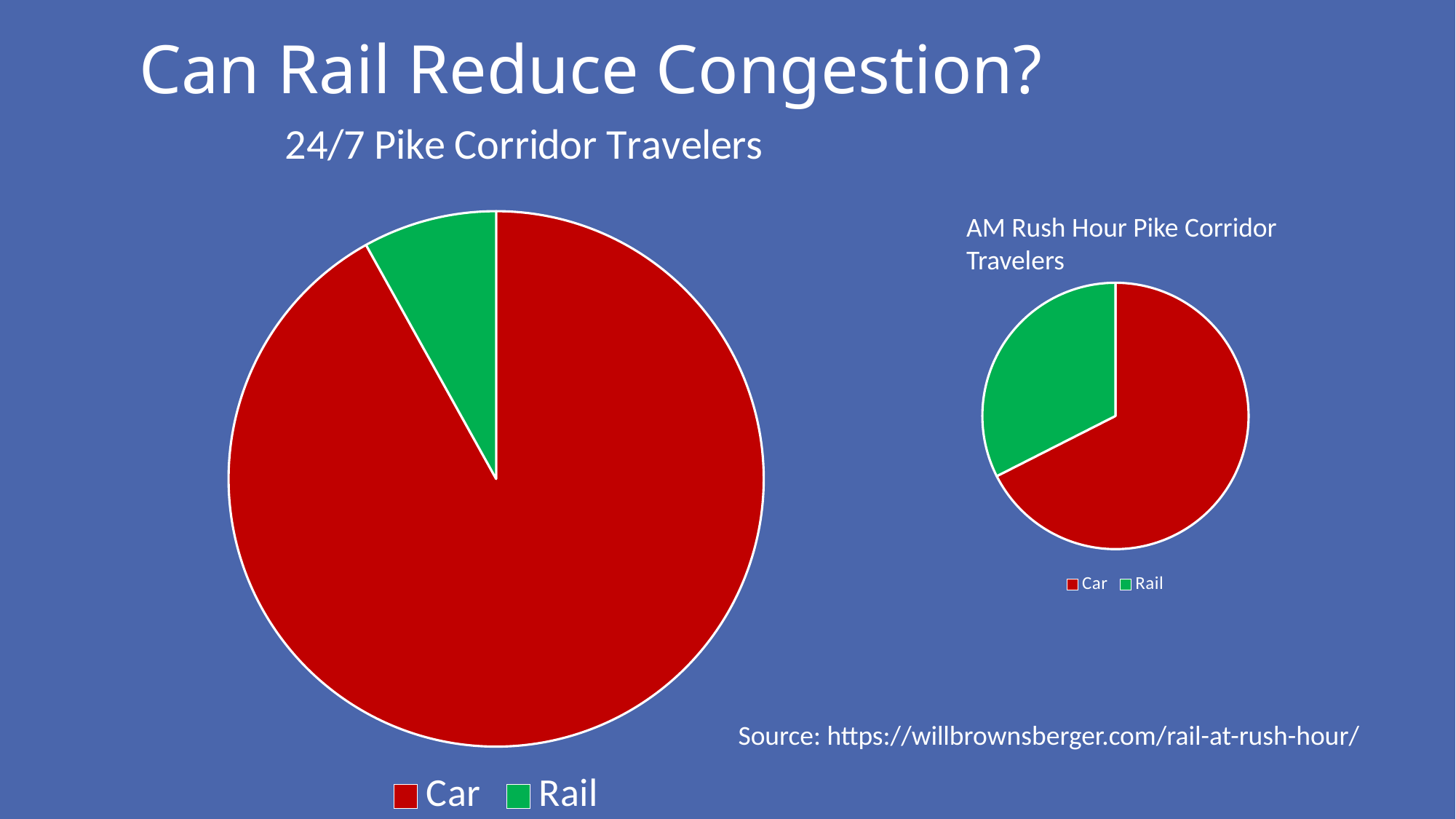
In the "AM Rush Hour Pike Corridor Travelers" chart, which category has the largest slice? Car In the "AM Rush Hour Pike Corridor Travelers" chart, what colour represents Rail? green In the "AM Rush Hour Pike Corridor Travelers" chart, which is larger, Car or Rail? Car How many categories does the "AM Rush Hour Pike Corridor Travelers" pie chart show? 2 In the "24/7 Pike Corridor Travelers" chart, which category has the largest slice? Car What kind of chart is the "24/7 Pike Corridor Travelers" chart? pie chart In the "24/7 Pike Corridor Travelers" chart, which category has the smallest slice? Rail What is the title of the larger pie chart on the left of the slide? 24/7 Pike Corridor Travelers What kind of chart is the "AM Rush Hour Pike Corridor Travelers" chart? pie chart In the "AM Rush Hour Pike Corridor Travelers" chart, which category has the smallest slice? Rail How many entries does the legend of the "24/7 Pike Corridor Travelers" chart list? 2 How many categories does the "24/7 Pike Corridor Travelers" pie chart show? 2